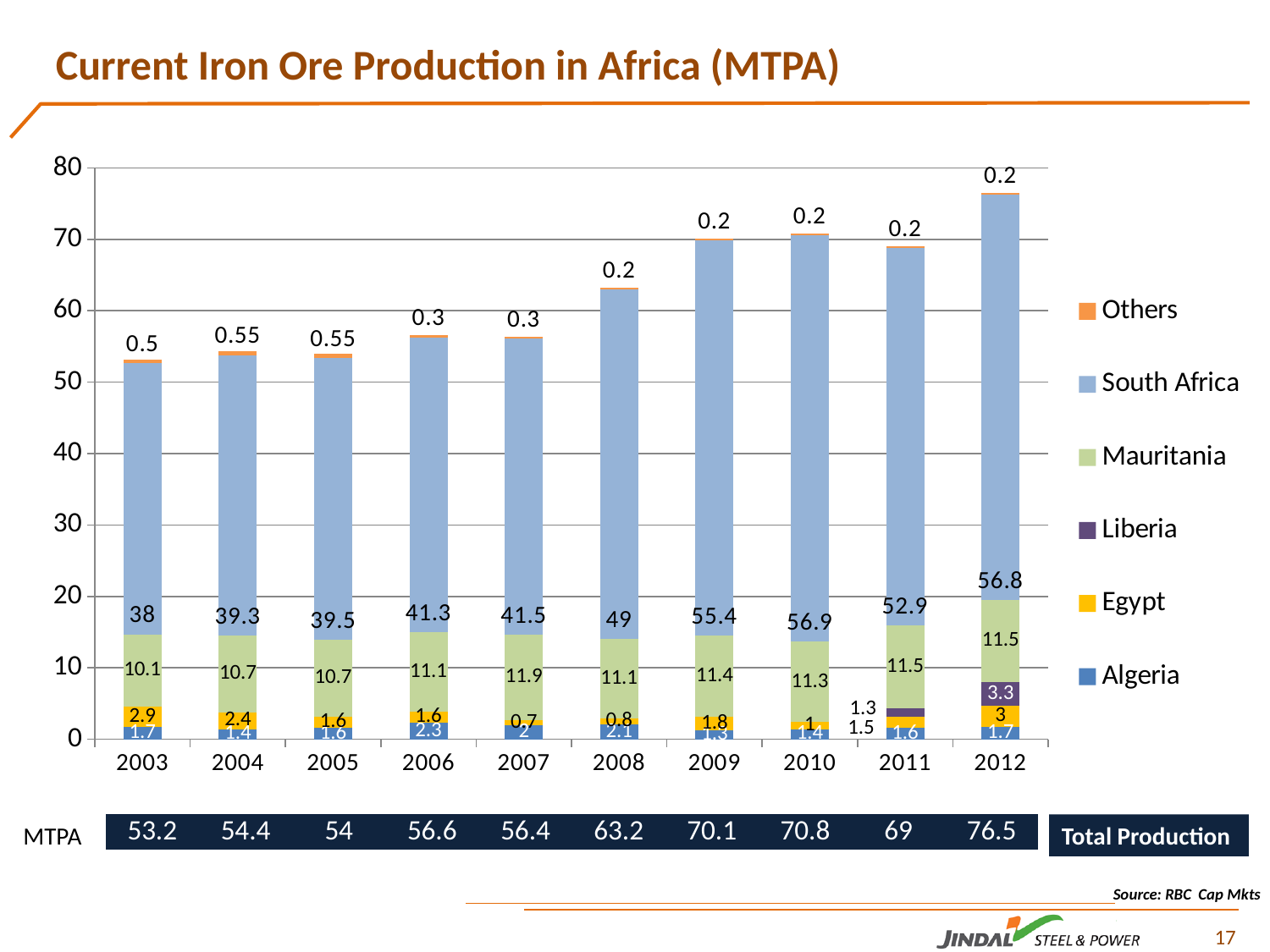
By how much did South Africa's production increase from 2003 to 2012? 18.8 Did South Africa's production generally rise or fall from 2003 to 2010? Rise How many years are shown on the x axis? 10 What was Mauritania's iron ore production in 2007? 11.9 Which year had the highest total iron ore production? 2012 How many series does the legend list? 6 Which year had the lowest total iron ore production? 2003 What kind of chart is shown on the slide? Stacked bar chart What was the total iron ore production in Africa in 2012 (MTPA)? 76.5 What was Liberia's iron ore production in 2012? 3.3 What was South Africa's iron ore production in 2008? 49 Which was larger, Egypt's production in 2003 or in 2007? 2003